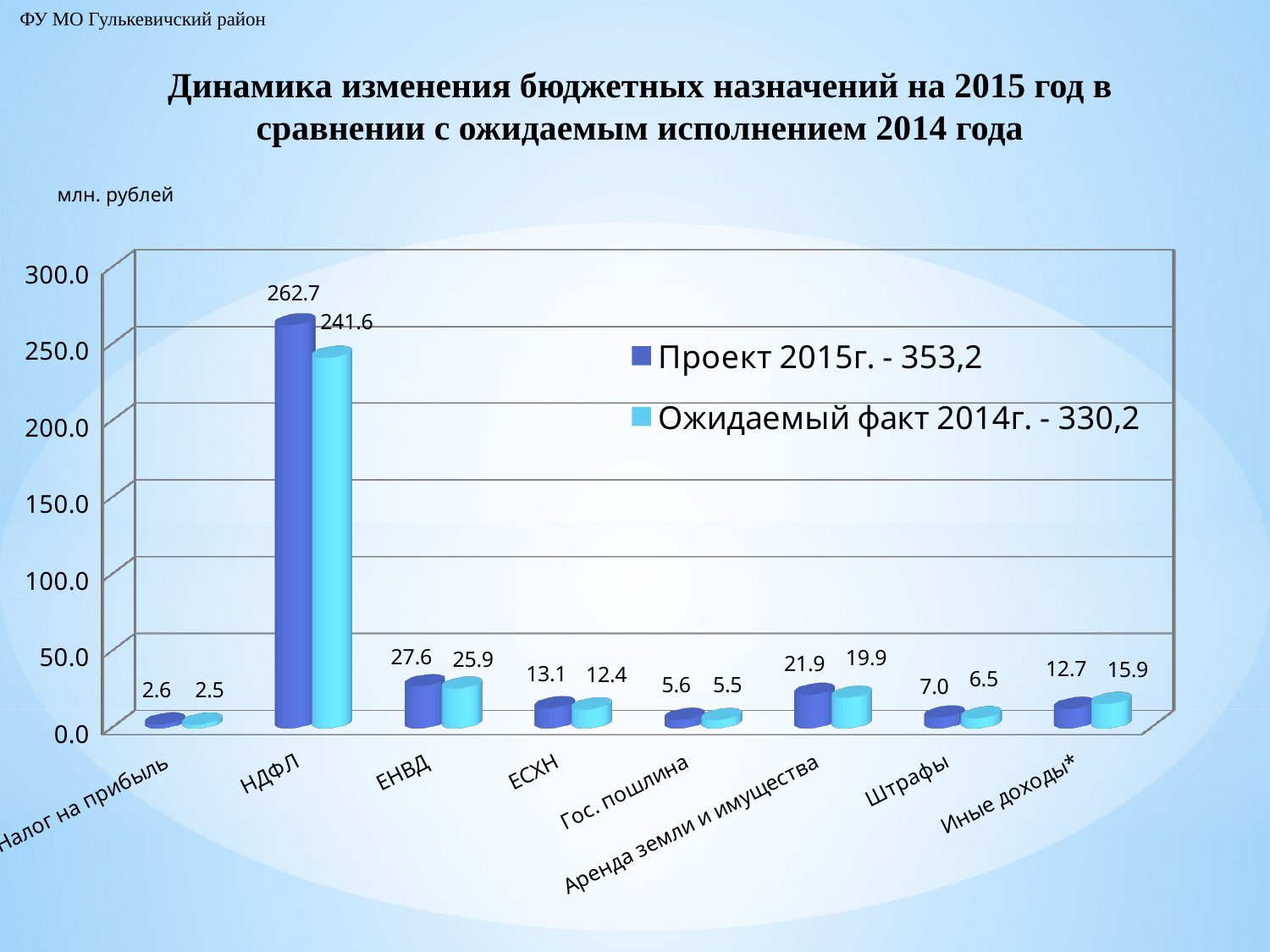
How many categories are shown on the x axis? 8 What kind of chart is shown on the slide? bar chart Which category has the highest value in the Проект 2015г. series? НДФЛ Is the Проект 2015г. value for НДФЛ greater or less than 250.0? greater What is the difference between the Проект 2015г. and Ожидаемый факт 2014г. values for НДФЛ? 21.1 How many series does the legend list? 2 What is the difference between the Ожидаемый факт 2014г. and Проект 2015г. values for Иные доходы*? 3.2 What is the value for Аренда земли и имущества in the Ожидаемый факт 2014г. series? 19.9 What is the value for Иные доходы* in the Проект 2015г. series? 12.7 What is the value for НДФЛ in the Проект 2015г. series? 262.7 Which category has the lowest value in the Ожидаемый факт 2014г. series? Налог на прибыль For ЕНВД, which series has the larger value: Проект 2015г. or Ожидаемый факт 2014г.? Проект 2015г.